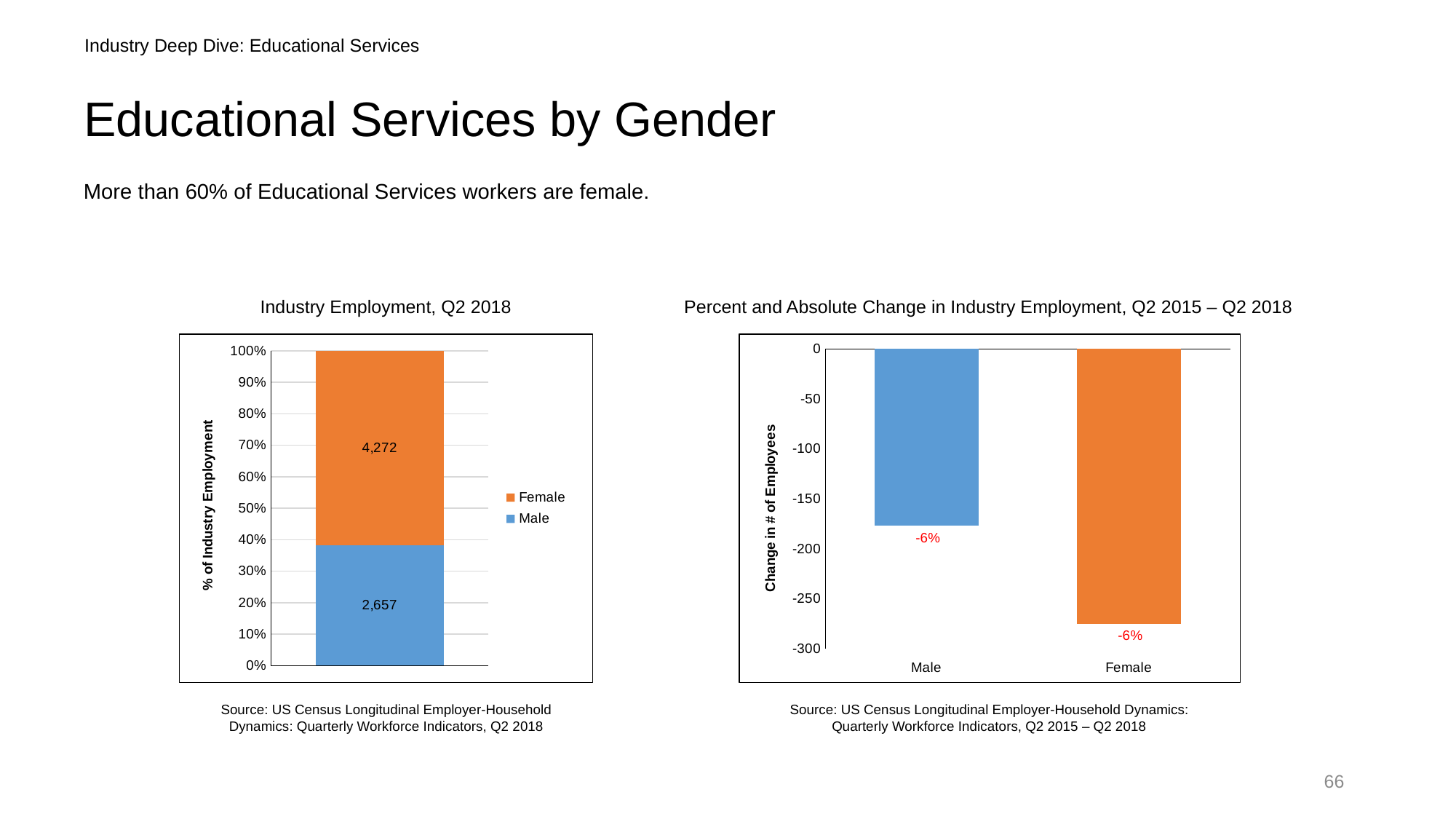
How many series does the legend of the Industry Employment, Q2 2018 chart list? 2 In the Percent and Absolute Change in Industry Employment, Q2 2015 – Q2 2018 chart, is the change in number of employees for Female greater or less than -250? less How many categories are shown on the x axis of the Percent and Absolute Change in Industry Employment, Q2 2015 – Q2 2018 chart? 2 In the Industry Employment, Q2 2018 chart, what is the total of the stacked bar (Female plus Male)? 6,929 In the Percent and Absolute Change in Industry Employment, Q2 2015 – Q2 2018 chart, is the change in number of employees for Male greater or less than -150? less In the Industry Employment, Q2 2018 chart, what is the value shown for Male? 2,657 In the Percent and Absolute Change in Industry Employment, Q2 2015 – Q2 2018 chart, which category shows the larger decline in number of employees? Female What kind of chart is the Industry Employment, Q2 2018 chart? Stacked bar chart In the Industry Employment, Q2 2018 chart, which is larger, the Female value or the Male value? Female In the Industry Employment, Q2 2018 chart, what is the difference between the Female and Male values? 1,615 In the Industry Employment, Q2 2018 chart, what is the value shown for Female? 4,272 In the Percent and Absolute Change in Industry Employment, Q2 2015 – Q2 2018 chart, what percent change is labelled for Male? -6%